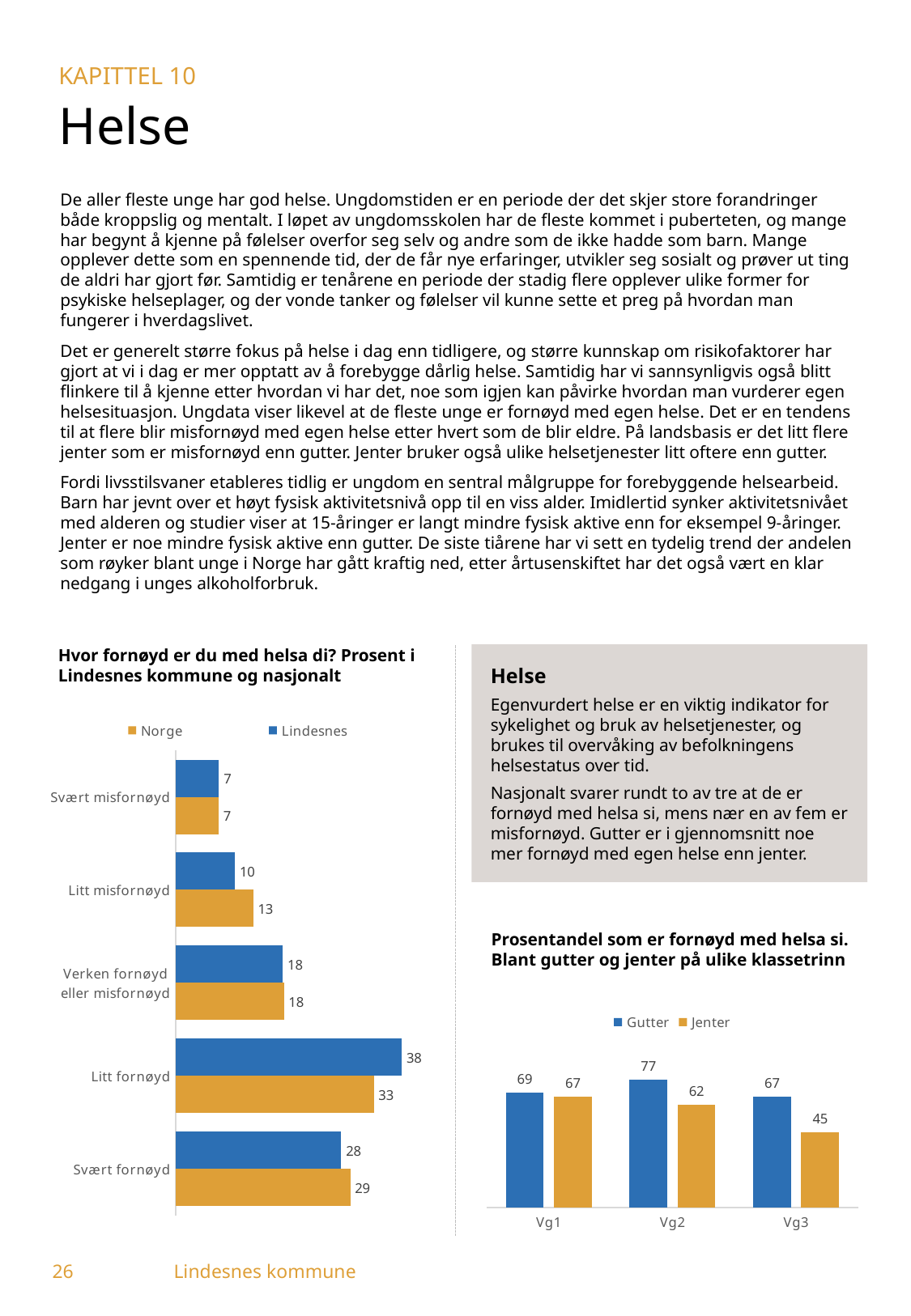
In the chart 'Hvor fornøyd er du med helsa di?', how many series does the legend list? 2 In the chart 'Hvor fornøyd er du med helsa di?', what is the difference between the Lindesnes and Norge values for 'Litt fornøyd'? 5 In the chart 'Hvor fornøyd er du med helsa di?', what is the value for Norge in the category 'Litt misfornøyd'? 13 In the chart 'Prosentandel som er fornøyd med helsa si', do the values for Jenter rise or fall from Vg1 to Vg3? Fall In the chart 'Prosentandel som er fornøyd med helsa si', which class level has the highest value for Gutter? Vg2 In the chart 'Prosentandel som er fornøyd med helsa si', which colour represents Gutter in the legend? Blue In the chart 'Hvor fornøyd er du med helsa di?', which category has the highest value for Lindesnes? Litt fornøyd What type of chart is 'Hvor fornøyd er du med helsa di?'? Bar chart In the chart 'Prosentandel som er fornøyd med helsa si', what is the difference between Gutter and Jenter at Vg2? 15 In the chart 'Hvor fornøyd er du med helsa di?', what is the value for Lindesnes in the category 'Litt fornøyd'? 38 In the chart 'Hvor fornøyd er du med helsa di?', how many categories are shown on the vertical axis? 5 In the chart 'Prosentandel som er fornøyd med helsa si', what is the value for Jenter at Vg3? 45